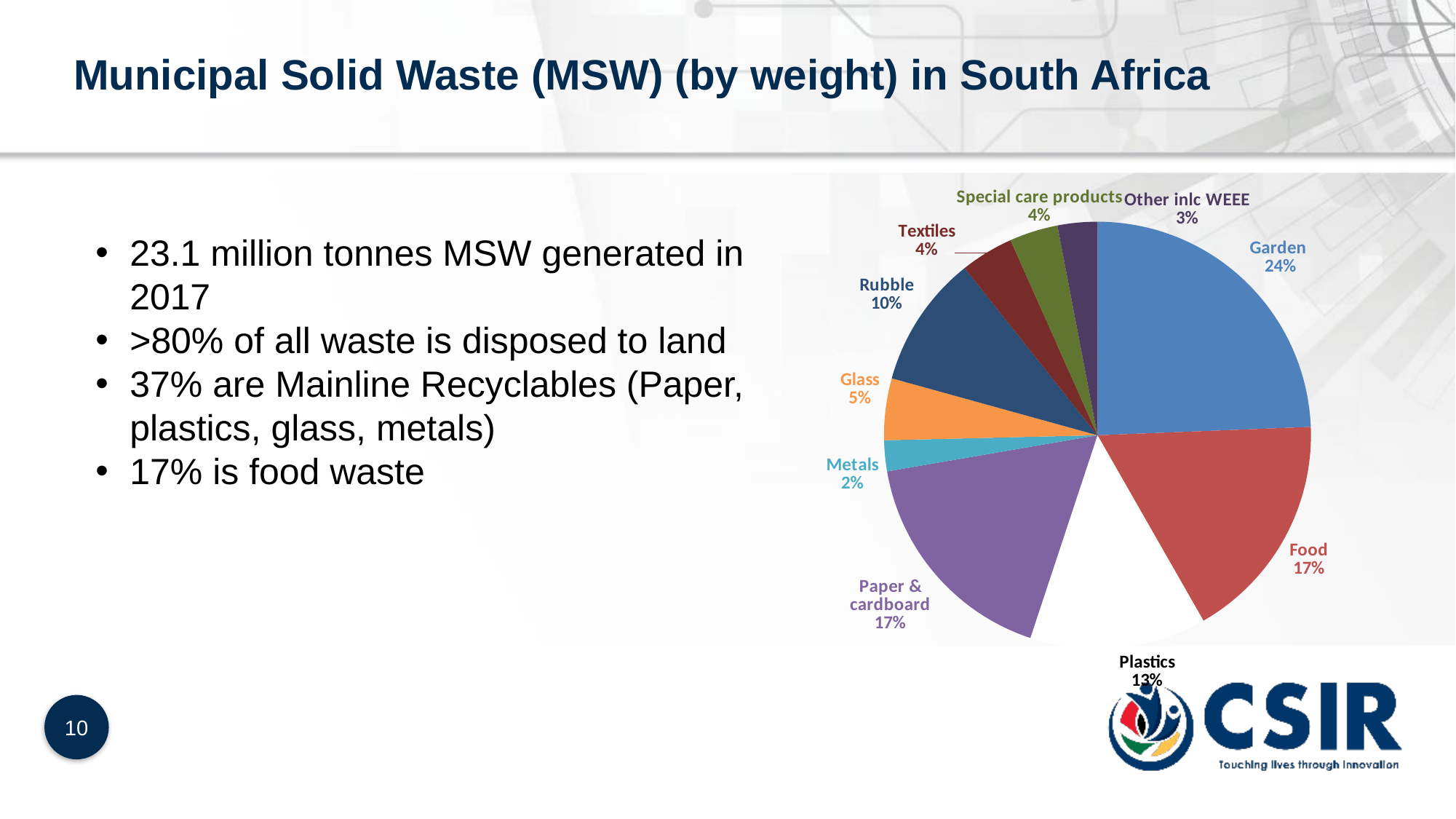
Which is larger, the Glass slice or the Rubble slice? Rubble What share of municipal solid waste is Garden waste? 24% What is the combined share of Food and Paper & cardboard? 34% What percentage is shown for Metals? 2% Which category has the smallest slice of the pie? Metals What share does Plastics account for in the pie chart? 13% How many categories are shown in the pie chart? 10 Which category has the largest slice of the pie? Garden What is the title of the slide containing the pie chart? Municipal Solid Waste (MSW) (by weight) in South Africa What type of chart is shown on the slide? pie chart What percentage of the pie is Rubble? 10% What is the difference in percentage points between Garden and Food? 7